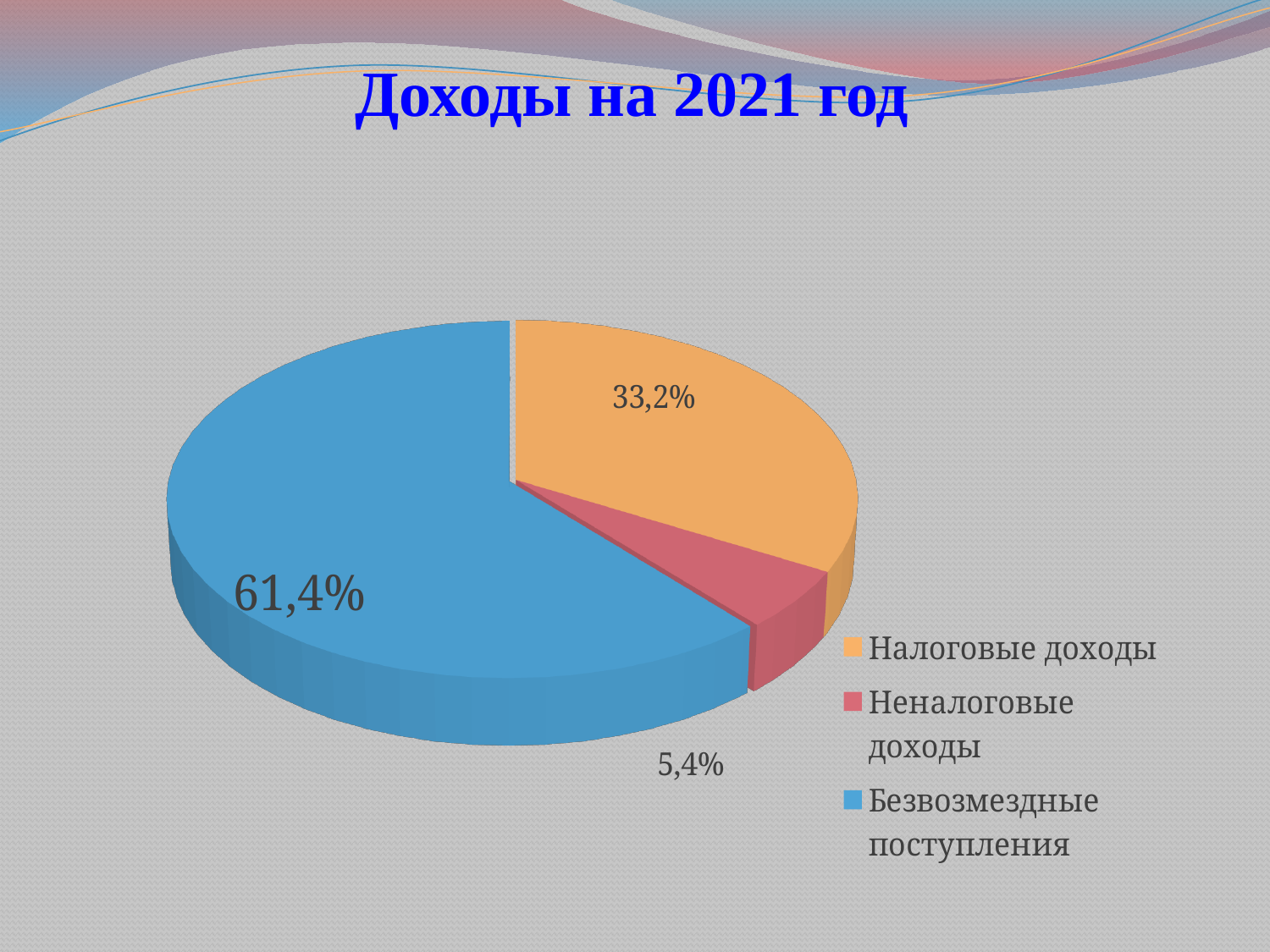
Which is larger, Налоговые доходы or Неналоговые доходы? Налоговые доходы What is the title of the slide? Доходы на 2021 год Which category has the largest slice of the pie? Безвозмездные поступления Which colour represents Неналоговые доходы in the legend? Red What kind of chart is shown on the slide? Pie chart What is the difference in percentage points between Налоговые доходы and Неналоговые доходы? 27,8 Which category has the smallest slice of the pie? Неналоговые доходы What share of the pie does Налоговые доходы have? 33,2% What is the difference in percentage points between Безвозмездные поступления and Налоговые доходы? 28,2 What share of the pie does Безвозмездные поступления have? 61,4% How many categories does the pie chart show? 3 What share of the pie does Неналоговые доходы have? 5,4%